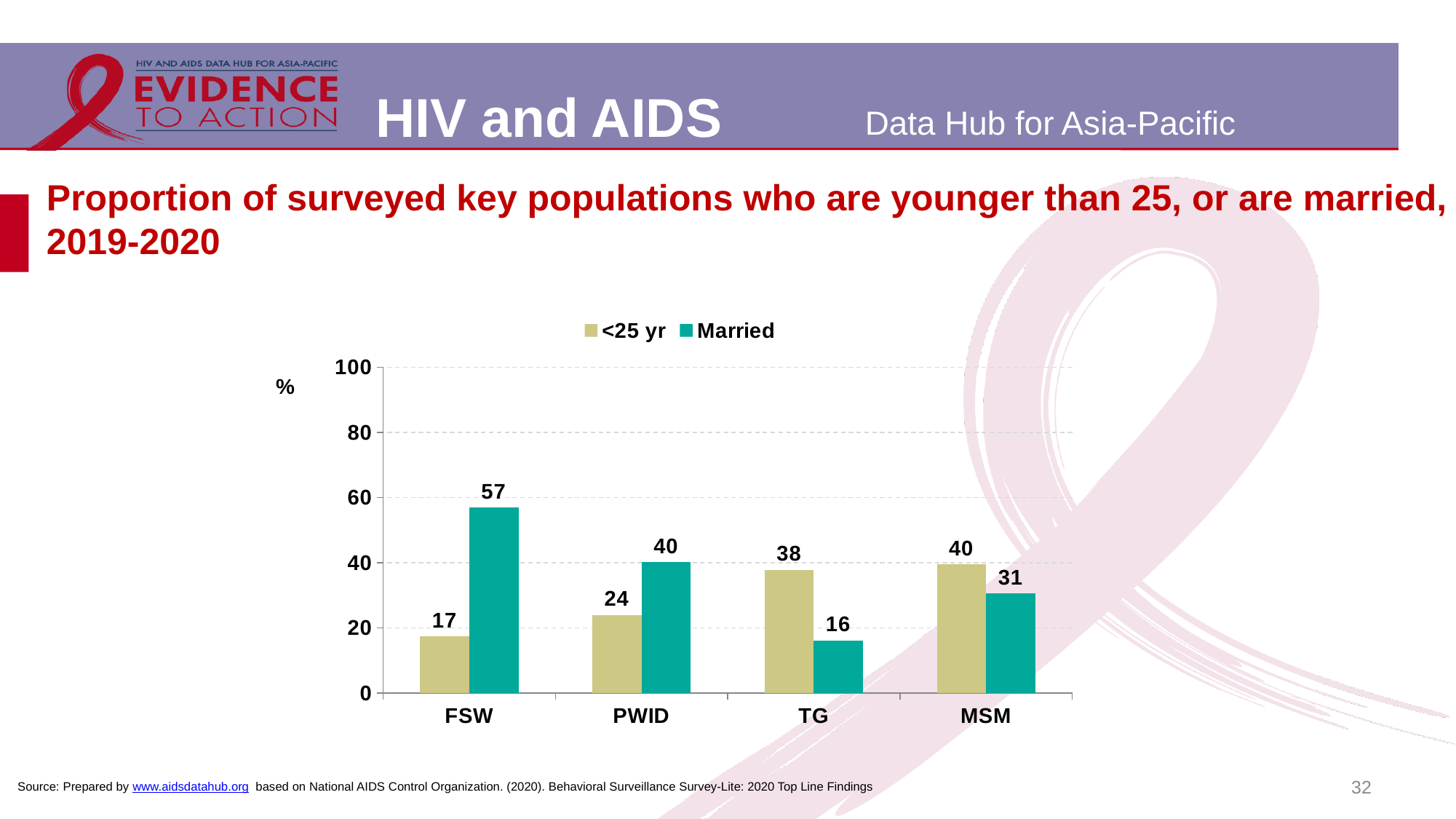
How many series does the legend list? 2 Which key population has the highest Married value? FSW What is the value for Married for TG? 16 Is the Married value for FSW greater or less than 40? greater What unit is shown on the y axis label? % What is the value for Married for PWID? 40 What is the value for <25 yr for FSW? 17 What kind of chart is shown on the slide? bar chart Which key population has the lowest <25 yr value? FSW Which is larger for MSM, the <25 yr value or the Married value? <25 yr How many key populations are shown on the x axis? 4 What is the difference between the Married and <25 yr values for FSW? 40